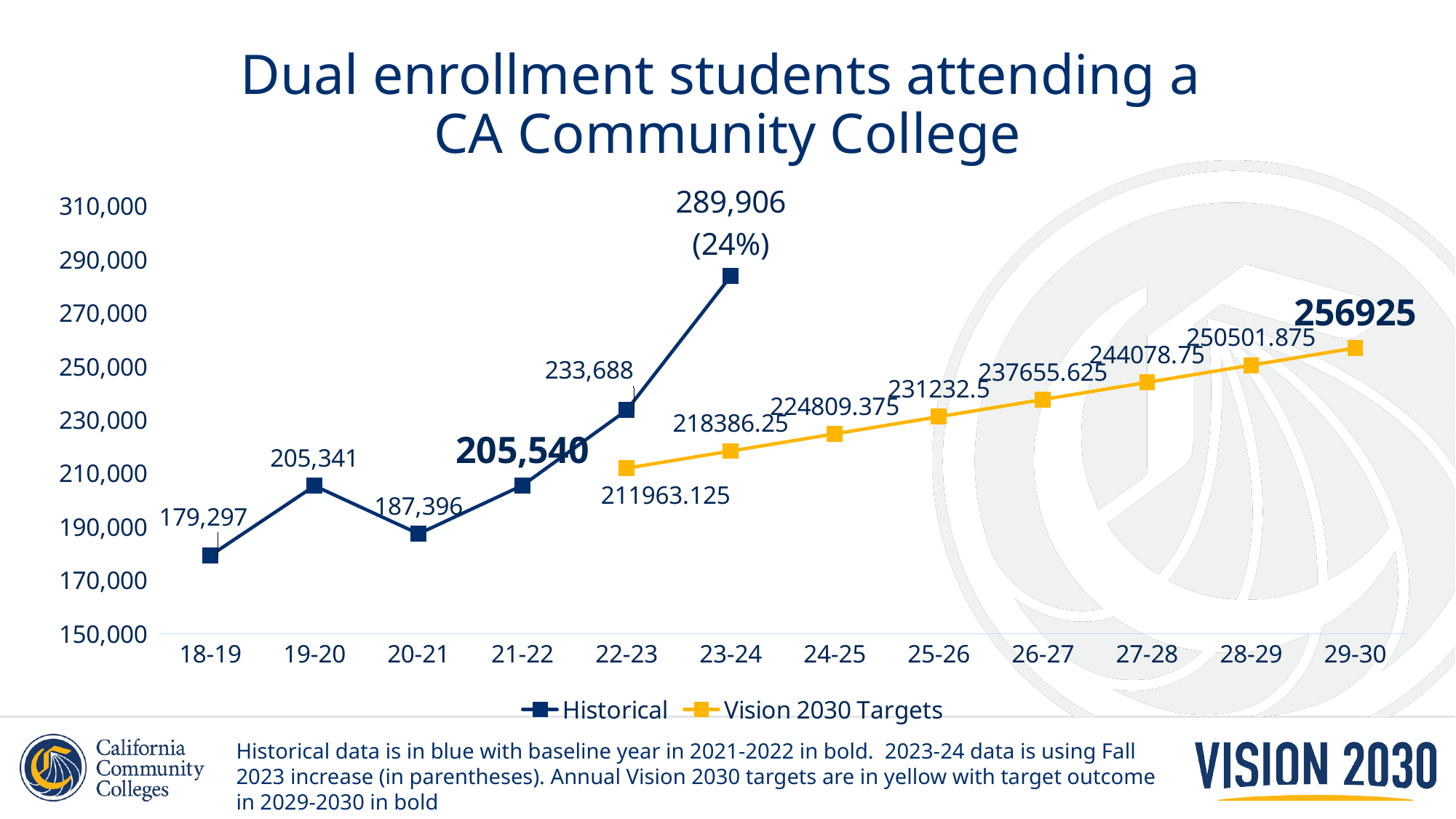
Is the Historical value for 23-24 greater or less than 270,000? greater What is the Historical value for 18-19? 179,297 What is the Vision 2030 Targets value for 29-30? 256925 What is the difference between the Historical values for 22-23 and 21-22? 28,148 How many academic years are shown on the x axis? 12 Do the Vision 2030 Targets values rise or fall from 22-23 to 29-30? rise Which is larger, the Historical value for 19-20 or for 20-21? 19-20 How many series does the legend list? 2 What kind of chart is shown on the slide? line chart Which year has the lowest Historical value? 18-19 Which year has the highest Historical value? 23-24 What is the Vision 2030 Targets value for 25-26? 231232.5